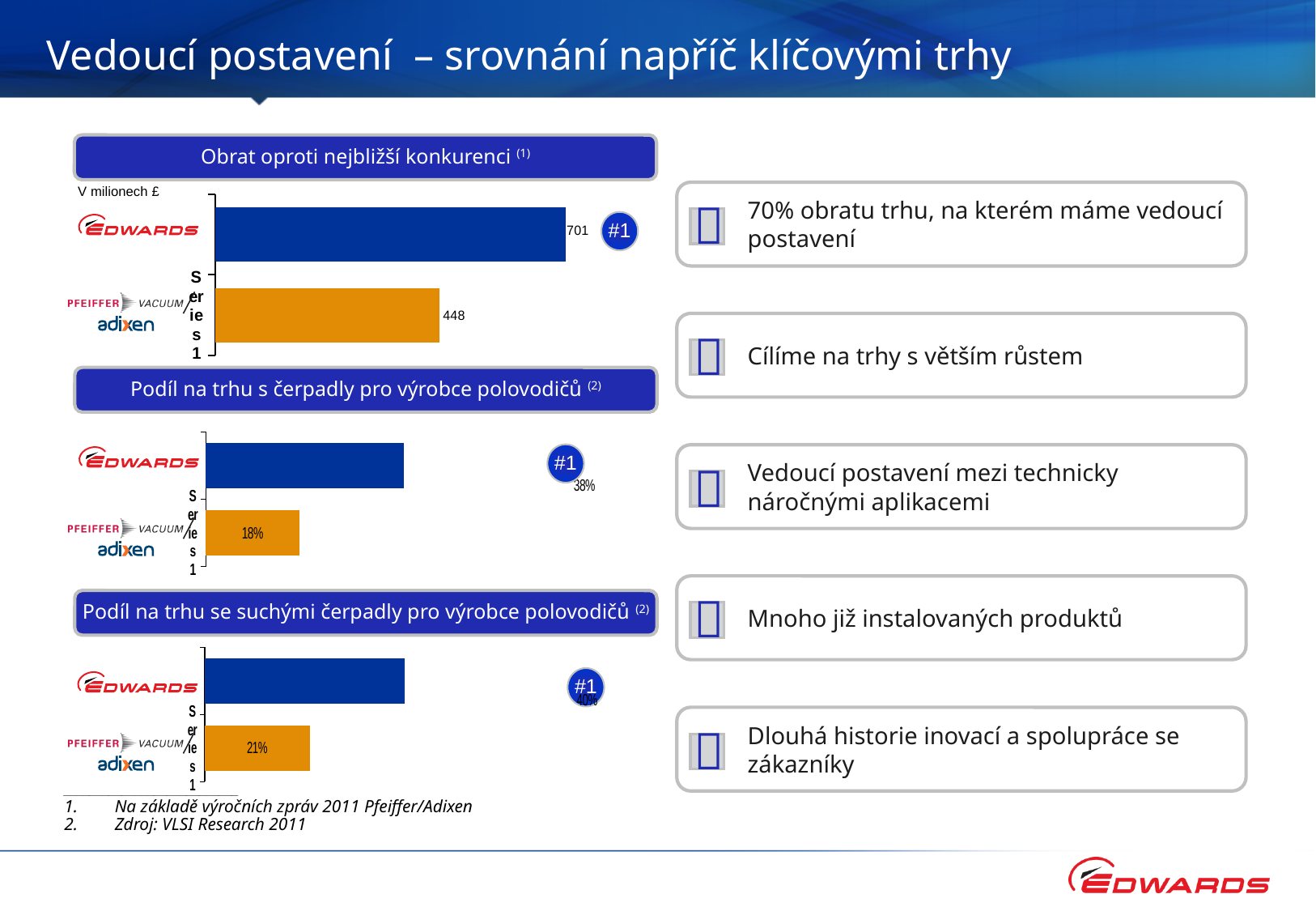
In the chart titled 'Obrat oproti nejbližší konkurenci', what is the difference between the Edwards value and the Pfeiffer Vacuum/Adixen value? 253 In the chart titled 'Obrat oproti nejbližší konkurenci', what is the value for Pfeiffer Vacuum/Adixen? 448 In the chart titled 'Obrat oproti nejbližší konkurenci', what unit is stated for the values? V milionech £ In the chart titled 'Podíl na trhu se suchými čerpadly pro výrobce polovodičů', which company has the larger bar, Edwards or Pfeiffer Vacuum/Adixen? Edwards In the chart titled 'Obrat oproti nejbližší konkurenci', which company has the higher value? Edwards In the chart titled 'Podíl na trhu s čerpadly pro výrobce polovodičů', what is the value for Pfeiffer Vacuum/Adixen? 18% In the chart titled 'Obrat oproti nejbližší konkurenci', what is the value for Edwards? 701 What type of chart is the chart titled 'Obrat oproti nejbližší konkurenci'? Bar chart In the chart titled 'Podíl na trhu se suchými čerpadly pro výrobce polovodičů', what is the value for Pfeiffer Vacuum/Adixen? 21% How many bars does the chart titled 'Podíl na trhu se suchými čerpadly pro výrobce polovodičů' show? 2 In the chart titled 'Podíl na trhu s čerpadly pro výrobce polovodičů', what is the value for Edwards? 38% In the chart titled 'Podíl na trhu s čerpadly pro výrobce polovodičů', what is the difference between the Edwards share and the Pfeiffer Vacuum/Adixen share? 20%